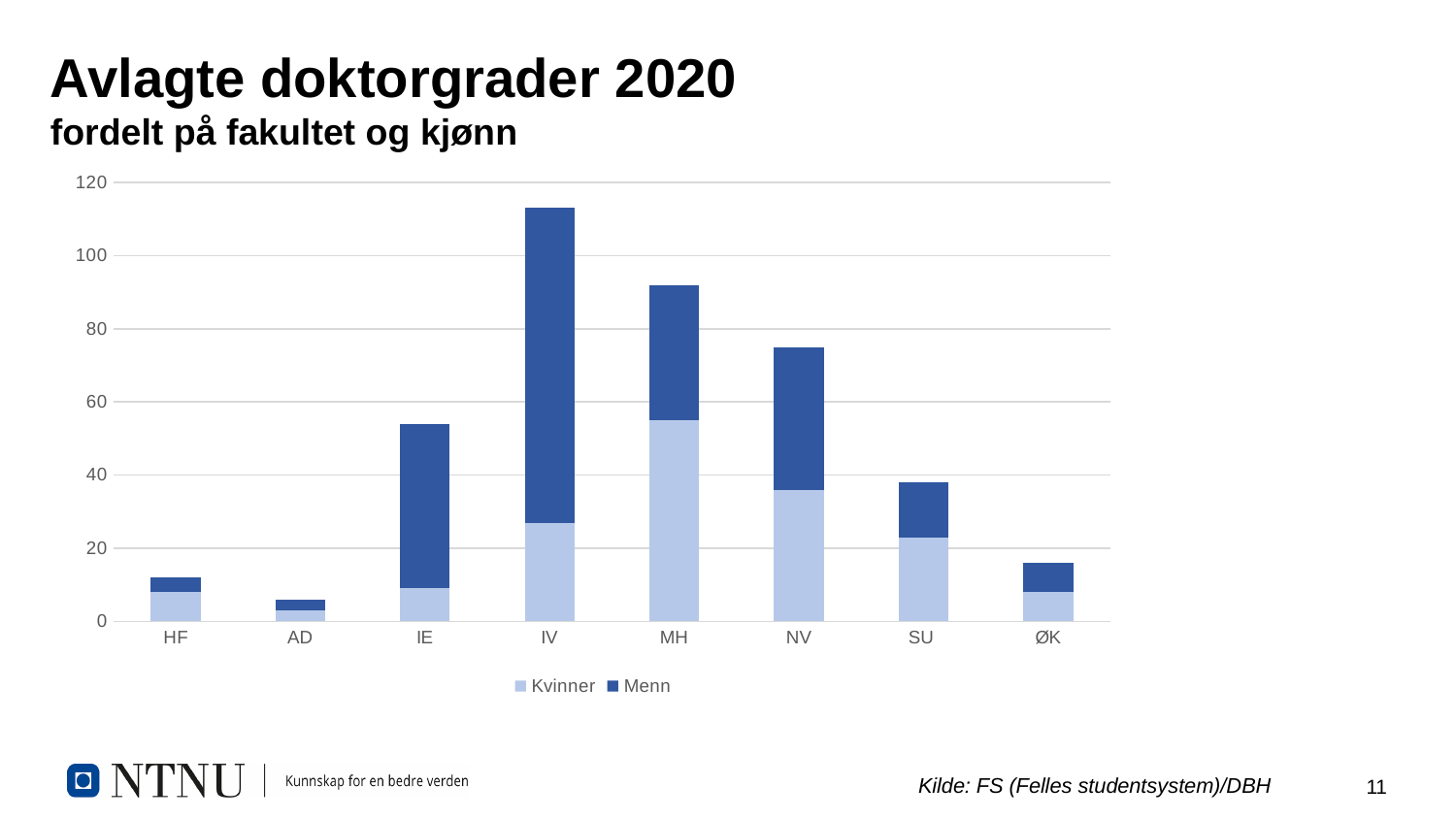
Which has a larger total, IE or SU? IE What are the two series named in the legend? Kvinner and Menn Is the total value for IE greater or less than 40? greater Which faculty has the highest total number of doctoral degrees? IV Is the Kvinner value for MH greater or less than 40? greater How many series does the legend list? 2 Which has a larger total, MH or NV? MH Which faculty has the lowest total number of doctoral degrees? AD Is the total value for NV greater or less than 80? less What kind of chart is shown on the slide? Stacked bar chart How many faculties are shown on the x axis? 8